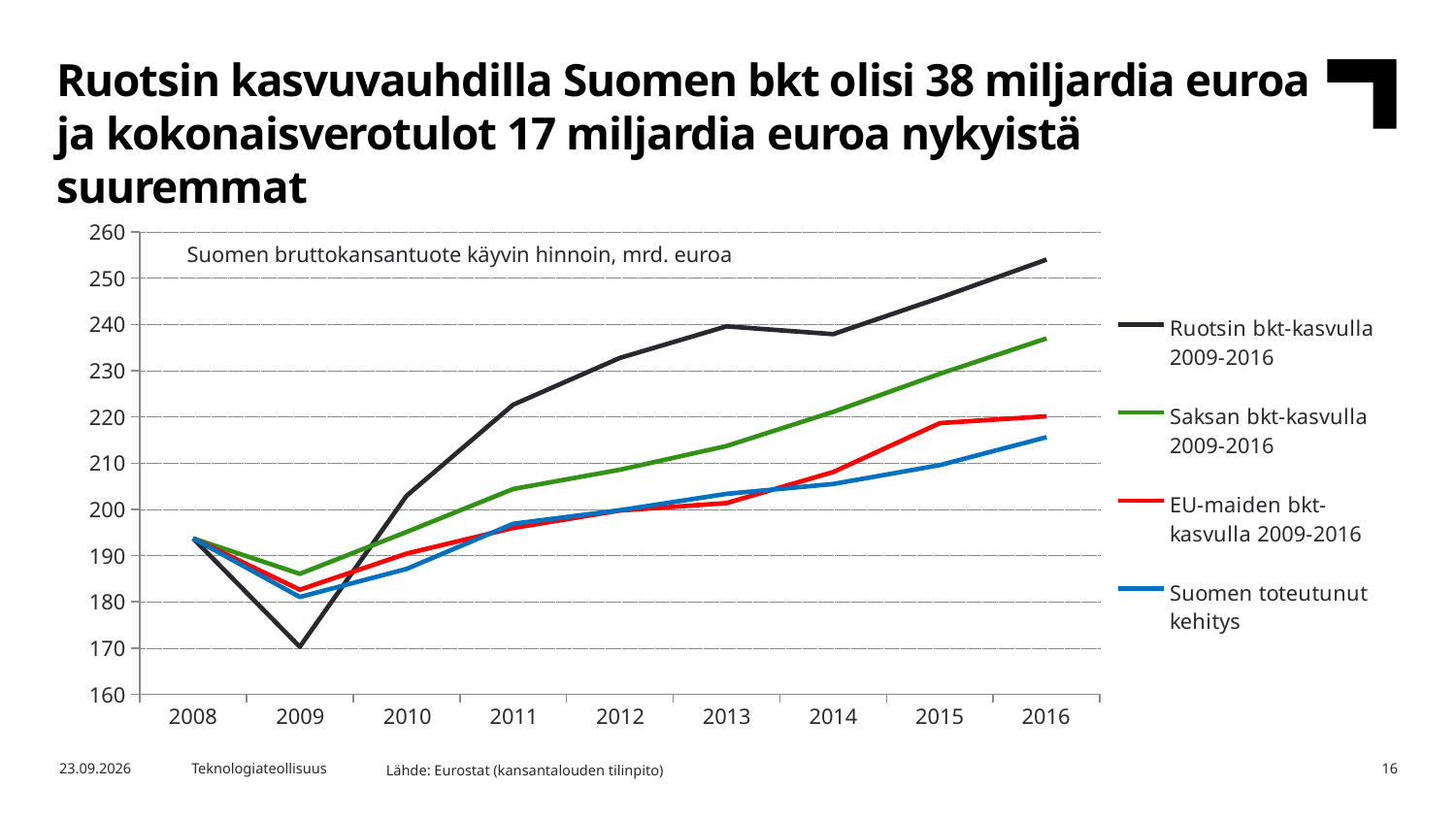
Which series has the highest value in 2016? Ruotsin bkt-kasvulla 2009-2016 Is the value for Ruotsin bkt-kasvulla 2009-2016 in 2016 greater or less than 250? greater In 2016, which is larger: Saksan bkt-kasvulla 2009-2016 or EU-maiden bkt-kasvulla 2009-2016? Saksan bkt-kasvulla 2009-2016 Which series has the lowest value in 2016? Suomen toteutunut kehitys What kind of chart is shown on the slide? Line chart Which series has the lowest value in 2009? Ruotsin bkt-kasvulla 2009-2016 Is the value for Suomen toteutunut kehitys in 2016 greater or less than 220? less Is the value for Ruotsin bkt-kasvulla 2009-2016 in 2009 greater or less than 180? less Does the Ruotsin bkt-kasvulla 2009-2016 series rise or fall from 2009 to 2016? Rises How many years are shown on the x axis of the chart? 9 What is the title printed inside the chart area? Suomen bruttokansantuote käyvin hinnoin, mrd. euroa How many series does the legend list? 4